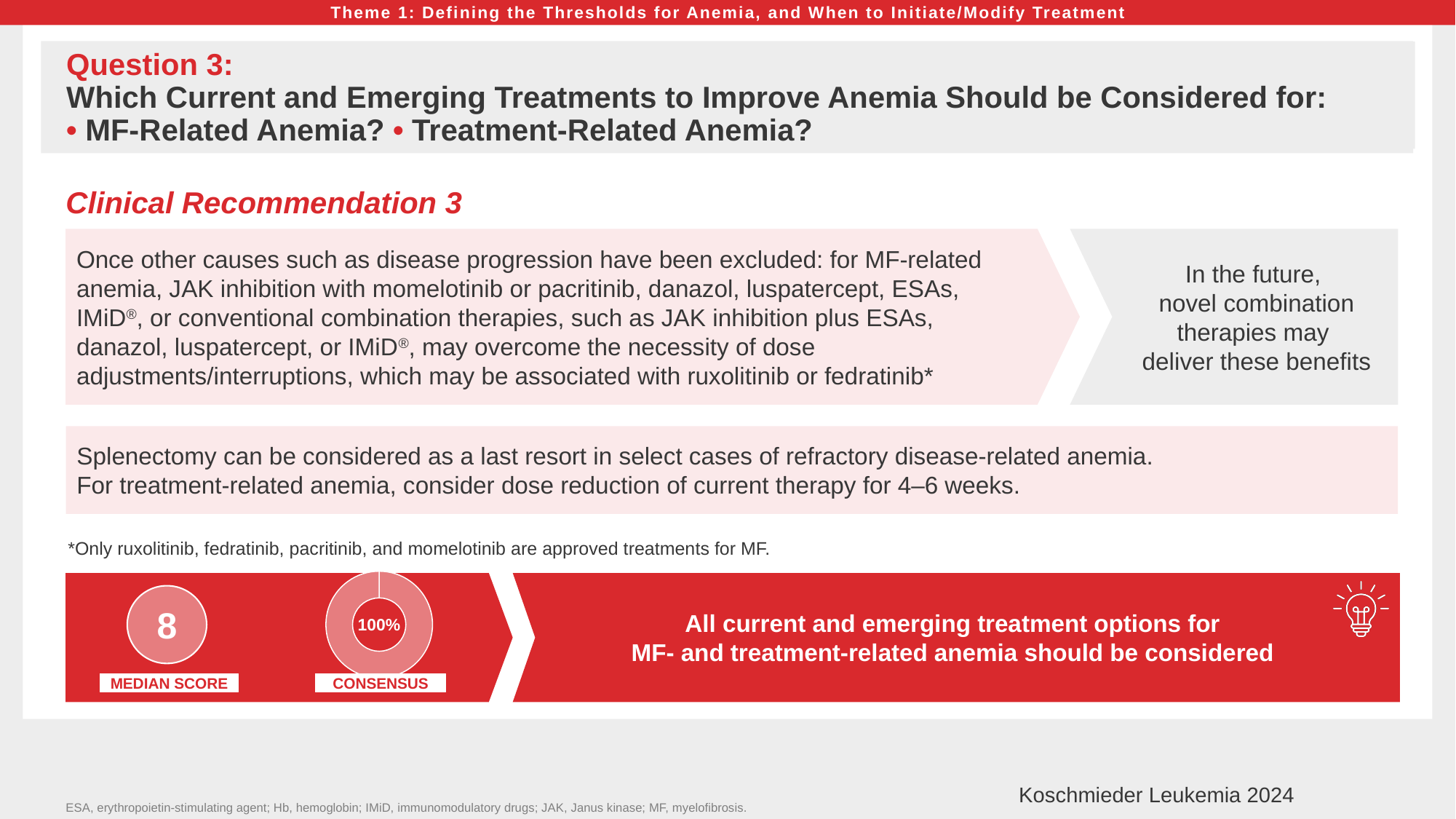
What percentage is shown in the centre of the consensus doughnut chart? 100% What median score is shown in the circle to the left of the consensus doughnut chart? 8 What share of the consensus doughnut chart is filled? 100% What kind of chart is used to display the consensus value? doughnut (pie) chart What label appears beneath the doughnut chart? CONSENSUS Is the consensus value shown in the doughnut chart greater or less than 50%? greater